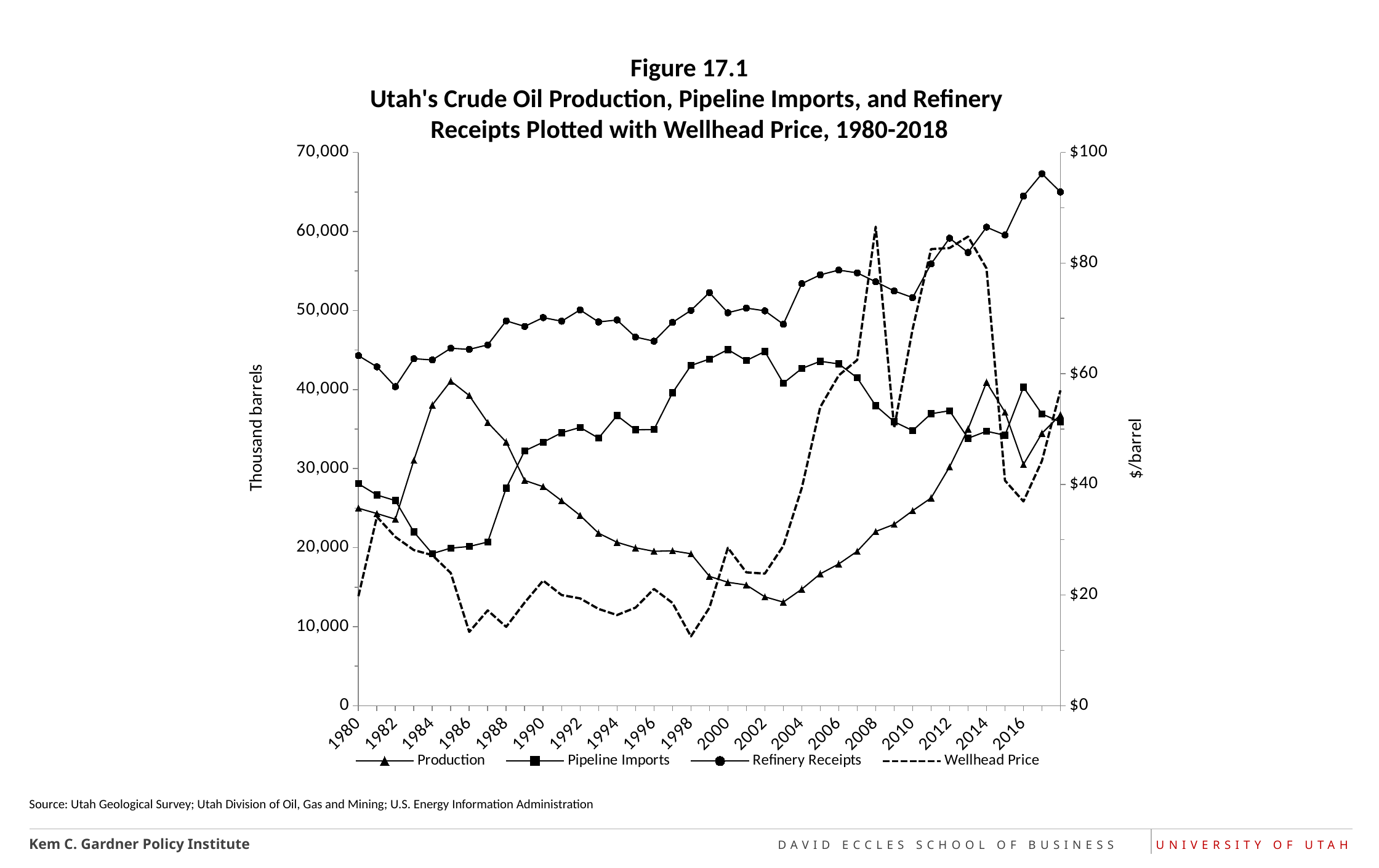
In 1980, which is larger: Refinery Receipts or Production? Refinery Receipts Which of the three barrel-volume series (Production, Pipeline Imports, Refinery Receipts) is highest in 2010? Refinery Receipts What kind of chart is shown in Figure 17.1? line chart Is the Wellhead Price in 2008 greater or less than $80? greater Is the value for Production in 2003 greater or less than 20,000? less In which year does the Wellhead Price reach its highest point? 2008 Is the Wellhead Price in 1998 greater or less than $20? less Does Production rise or fall between 1985 and 2003? fall Which series is drawn with a dashed line? Wellhead Price How many series does the legend list? 4